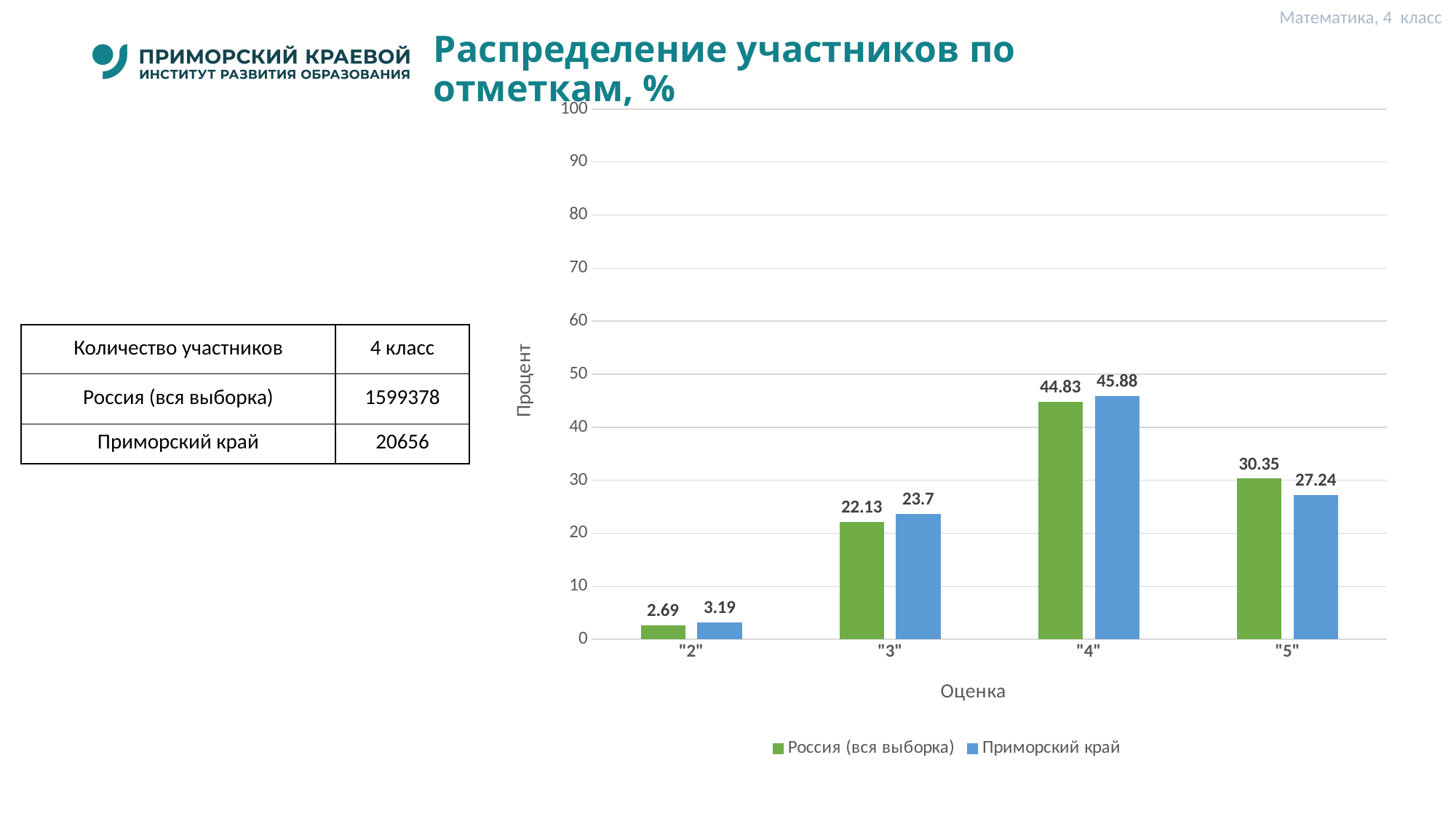
What is the value for Приморский край for grade "2"? 3.19 Which grade has the lowest value for Россия (вся выборка)? "2" How many series does the legend list? 2 What is the difference between Россия (вся выборка) and Приморский край for grade "5"? 3.11 What is the value for Приморский край for grade "3"? 23.7 What kind of chart is shown on the slide? bar chart Which grade has the highest value for Приморский край? "4" What is the value for Россия (вся выборка) for grade "4"? 44.83 What is the label of the y axis? Процент Is the value for Россия (вся выборка) for grade "5" greater or less than 40? less How many grade categories are shown on the x axis? 4 For grade "3", which series has the larger value: Россия (вся выборка) or Приморский край? Приморский край